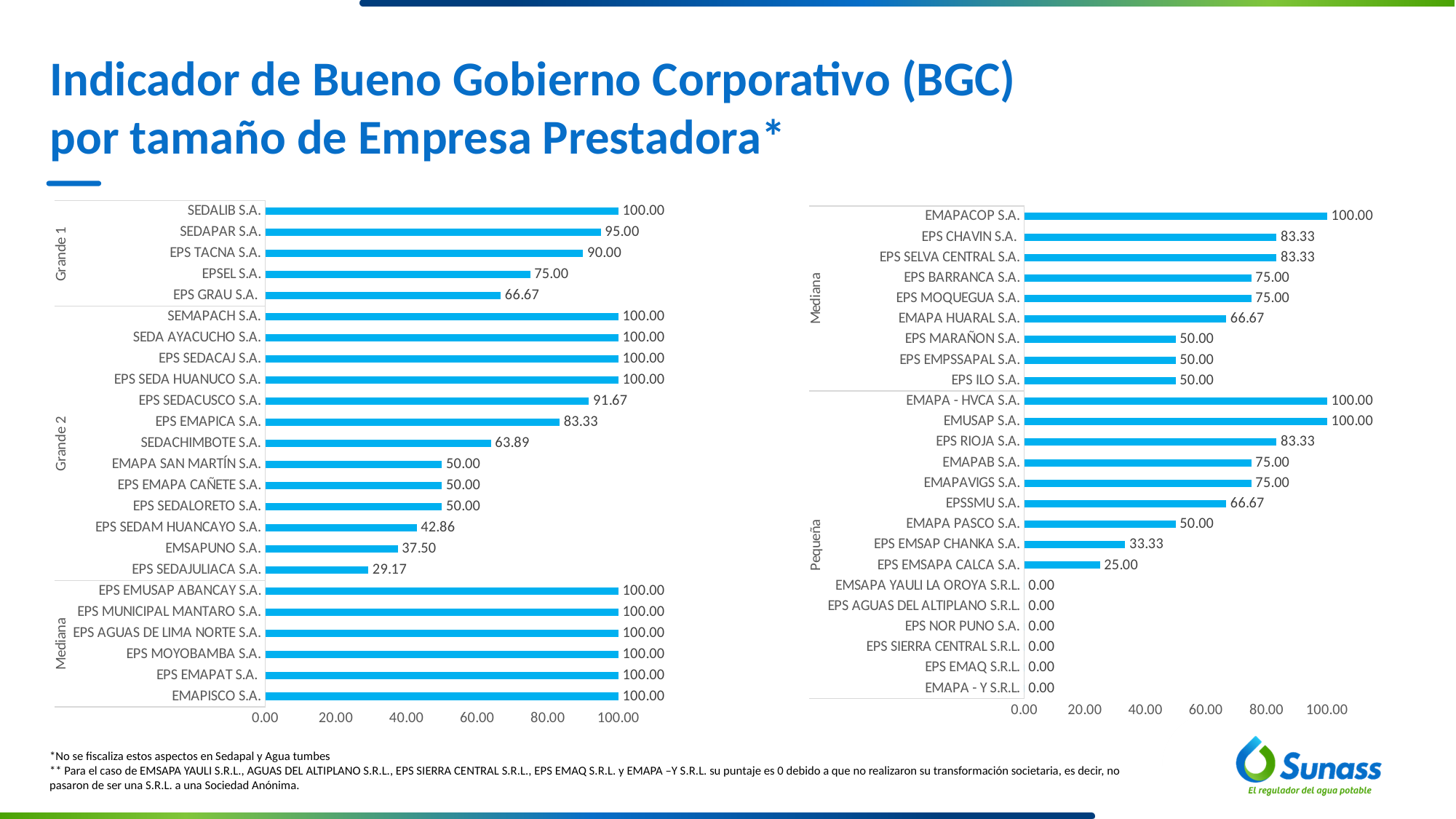
What type of chart is used on this slide? Bar chart In the left chart, what is the difference between the values for SEDAPAR S.A. and EPS GRAU S.A.? 28.33 In the right chart, what is the value for EMAPA HUARAL S.A.? 66.67 In the left chart, how many companies are listed in the Grande 1 group? 5 In the right chart, how many companies have a value of 0.00? 6 In the right chart, what is the value for EPS EMSAP CHANKA S.A.? 33.33 In the left chart, what is the value for EPS SEDACUSCO S.A.? 91.67 In the left chart, which is larger, the value for SEDACHIMBOTE S.A. or the value for EPS SEDAM HUANCAYO S.A.? SEDACHIMBOTE S.A. In the right chart, how many companies are listed in the Pequeña group? 15 In the left chart, what is the value for EMSAPUNO S.A.? 37.50 In the left chart, which company has the lowest value? EPS SEDAJULIACA S.A. In the right chart, what is the difference between the values for EPS RIOJA S.A. and EPS EMSAPA CALCA S.A.? 58.33